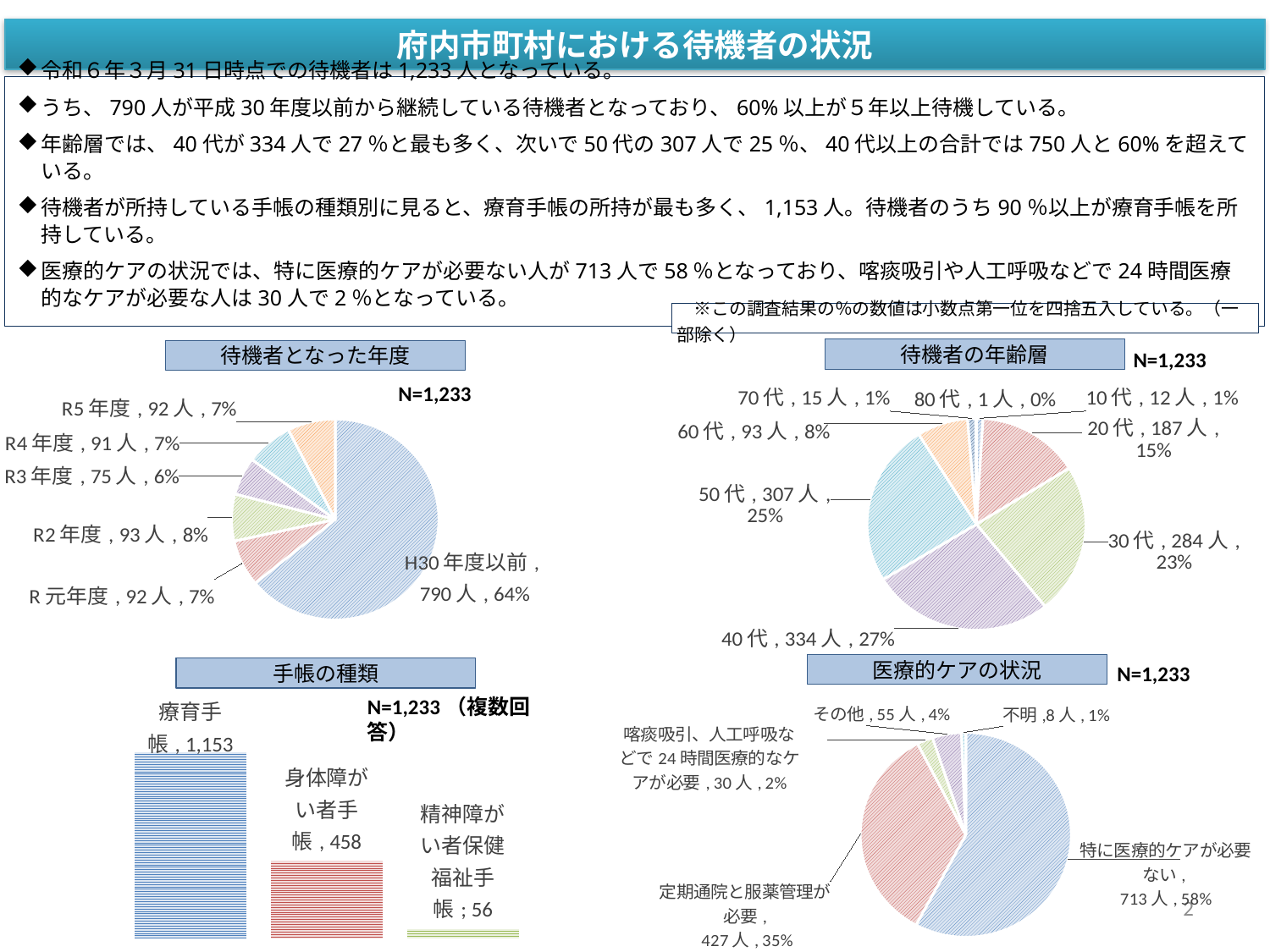
In the 「待機者となった年度」 chart, what share of the pie does R3年度 represent? 6% In the 「手帳の種類」 chart, what is the value for 身体障がい者手帳? 458 In the 「待機者の年齢層」 chart, which age group has the largest number of people? 40代 In the 「医療的ケアの状況」 chart, what share of the pie does 特に医療的ケアが必要ない represent? 58% In the 「待機者となった年度」 chart, which category has the smallest number of people? R3年度 In the 「待機者の年齢層」 chart, how many age categories are shown? 8 In the 「医療的ケアの状況」 chart, which category is larger: 定期通院と服薬管理が必要 or その他? 定期通院と服薬管理が必要 What kind of chart is the 「手帳の種類」 chart? Bar chart In the 「待機者の年齢層」 chart, what is the difference in people between 40代 and 50代? 27人 In the 「待機者となった年度」 chart, how many categories are shown? 6 In the 「待機者の年齢層」 chart, how many people are in the 20代 category? 187人 In the 「待機者となった年度」 chart, how many people are in the H30年度以前 category? 790人